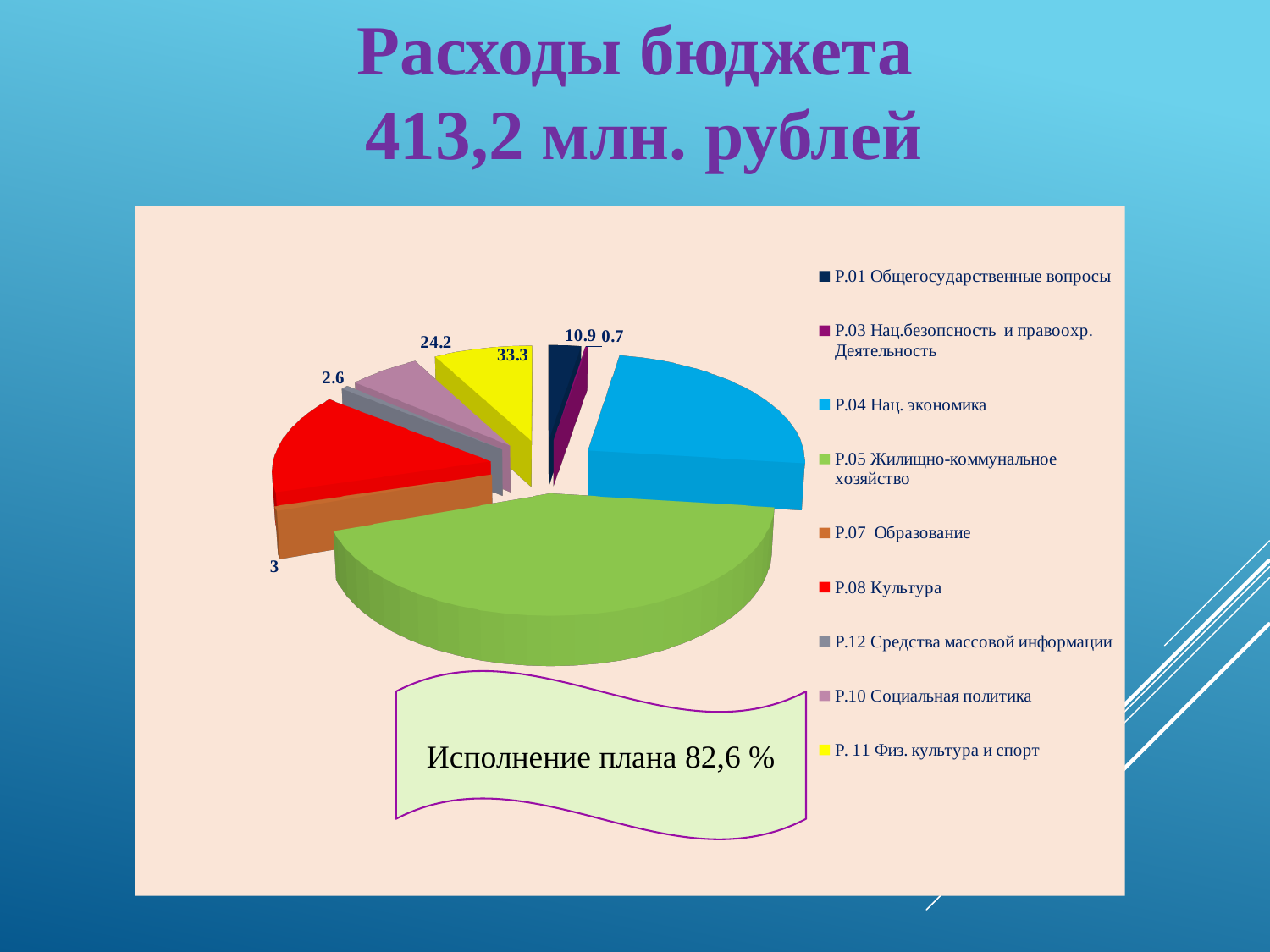
What value is labelled for Р.03 Нац.безопасность и правоохр. Деятельность? 0.7 How many categories does the legend of the pie chart list? 9 What colour is the slice for Р.08 Культура? red What value is labelled for Р.01 Общегосударственные вопросы? 10.9 Which slice is larger: Р.04 Нац. экономика or Р.11 Физ. культура и спорт? Р.04 Нац. экономика Which category has the largest slice of the pie chart? Р.05 Жилищно-коммунальное хозяйство What plan execution percentage is stated in the banner below the pie chart? 82,6 % What value is labelled on the yellow slice for Р. 11 Физ. культура и спорт? 33.3 Which slice is larger: Р.04 Нац. экономика or Р.05 Жилищно-коммунальное хозяйство? Р.05 Жилищно-коммунальное хозяйство What is the difference between the labelled values for Р.01 Общегосударственные вопросы and Р.03 Нац.безопасность и правоохр. Деятельность? 10.2 What kind of chart is shown on the slide? pie chart What is the title of the slide containing the pie chart? Расходы бюджета 413,2 млн. рублей